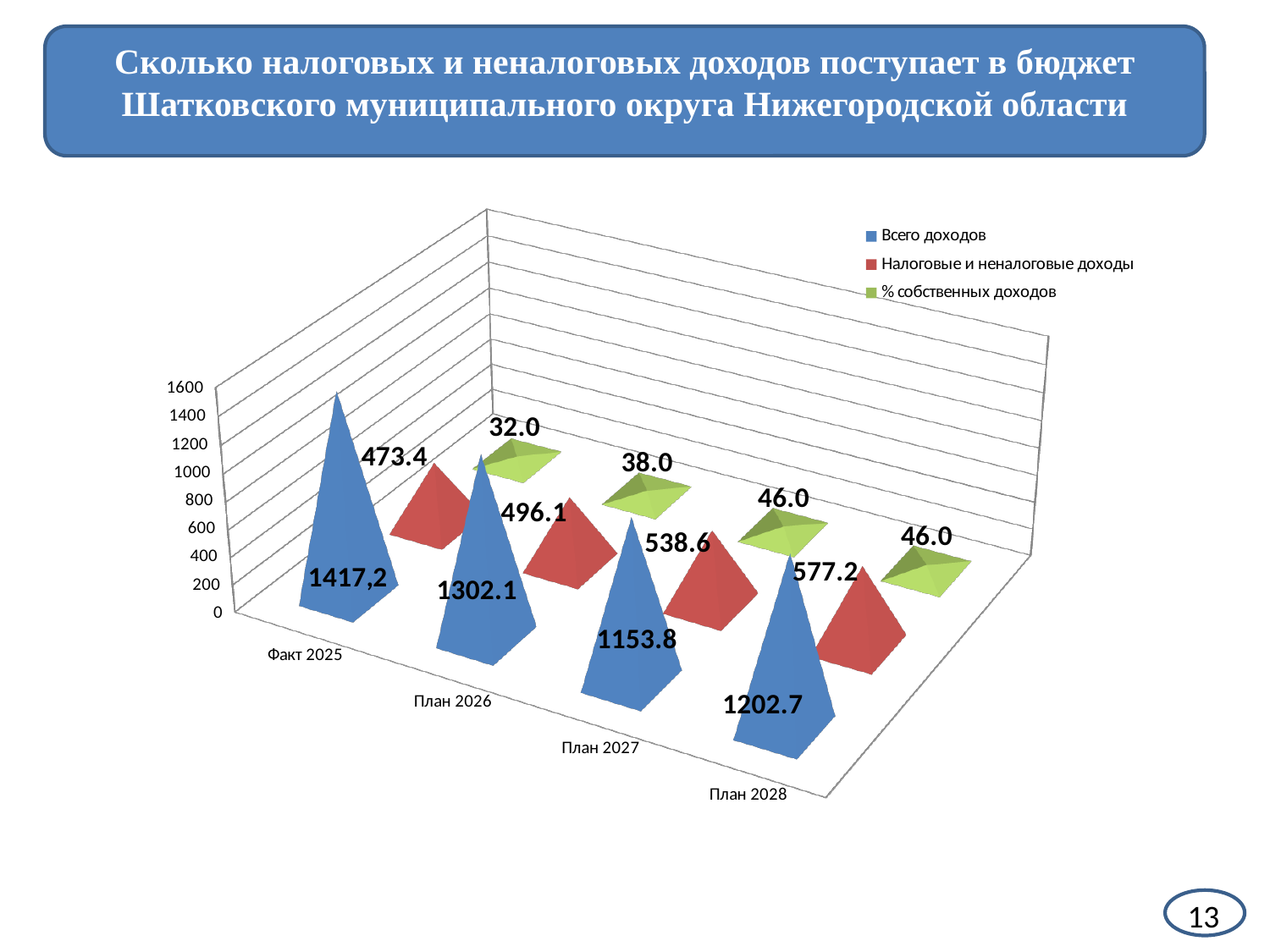
Do the values for Налоговые и неналоговые доходы rise or fall from Факт 2025 to План 2028? rise How many categories are shown on the x axis? 4 Which category has the highest value for Всего доходов? Факт 2025 What is the difference between Всего доходов for Факт 2025 and План 2026? 115.1 Which is larger for Всего доходов: План 2027 or План 2028? План 2028 What is the difference between Налоговые и неналоговые доходы for План 2028 and Факт 2025? 103.8 What is the value of Всего доходов for Факт 2025? 1417,2 How many series does the legend list? 3 Which category has the highest value for Налоговые и неналоговые доходы? План 2028 Which category has the lowest value for Всего доходов? План 2027 What is the value of % собственных доходов for План 2026? 38.0 What is the value of Налоговые и неналоговые доходы for План 2028? 577.2